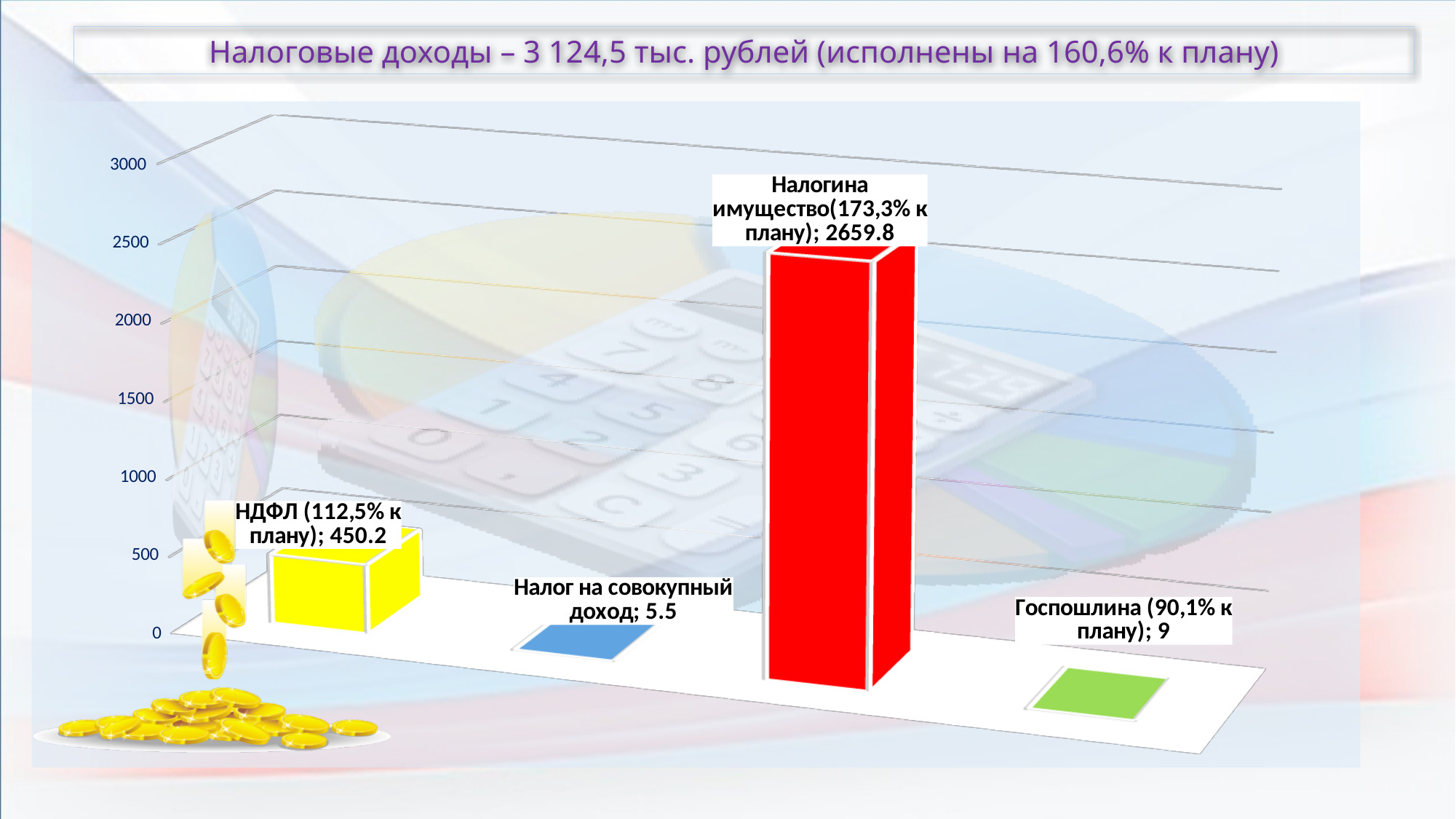
Which category has the highest value? Налог на имущество What percentage of plan is shown in the label for Налог на имущество? 173,3% What is the difference between the values for Налог на имущество and НДФЛ? 2209.6 What kind of chart is shown on the slide? bar chart What is the value shown for Налог на совокупный доход? 5.5 What is the value shown for Госпошлина? 9 Which is larger, the value for Госпошлина or the value for Налог на совокупный доход? Госпошлина What is the value shown for НДФЛ? 450.2 Which category has the lowest value? Налог на совокупный доход How many categories are plotted in the chart? 4 What is the value shown for Налог на имущество? 2659.8 Is the value for Налог на имущество greater or less than 2500? greater